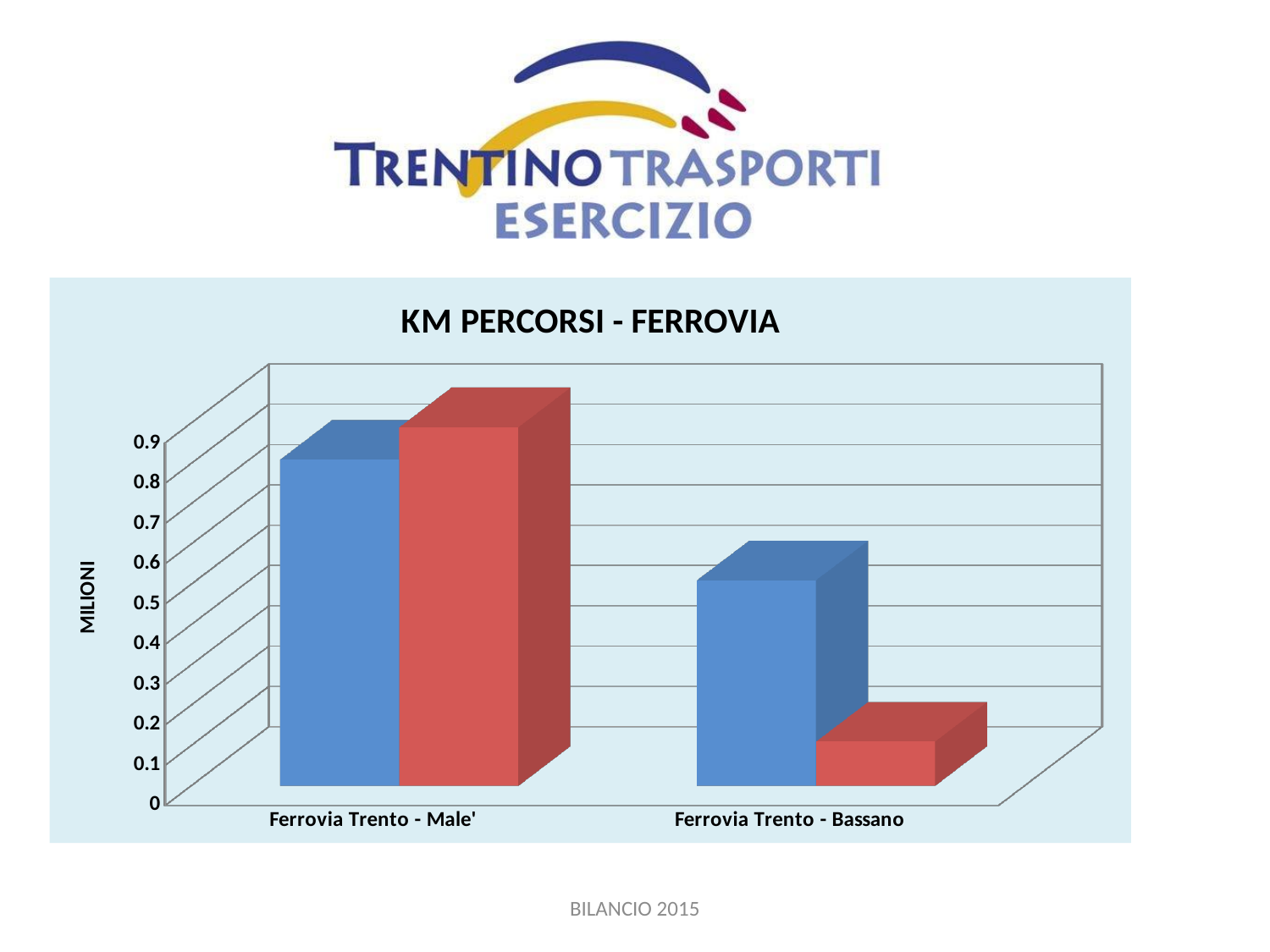
How many bars are shown for the category Ferrovia Trento - Bassano? 2 For Ferrovia Trento - Bassano, which bar is larger, the blue one or the red one? the blue one What is the title of the chart? KM PERCORSI - FERROVIA What is the label of the vertical axis of the chart? MILIONI Is the value of the blue bar for Ferrovia Trento - Male' greater or less than 0.5? greater How many categories are shown on the x axis of the chart? 2 Which bar in the chart has the lowest value? the red bar for Ferrovia Trento - Bassano Is the value of the red bar for Ferrovia Trento - Male' greater or less than 0.5? greater What type of chart is shown on the slide? bar chart Is the value of the red bar for Ferrovia Trento - Bassano greater or less than 0.3? less Which category has the larger blue bar, Ferrovia Trento - Male' or Ferrovia Trento - Bassano? Ferrovia Trento - Male'